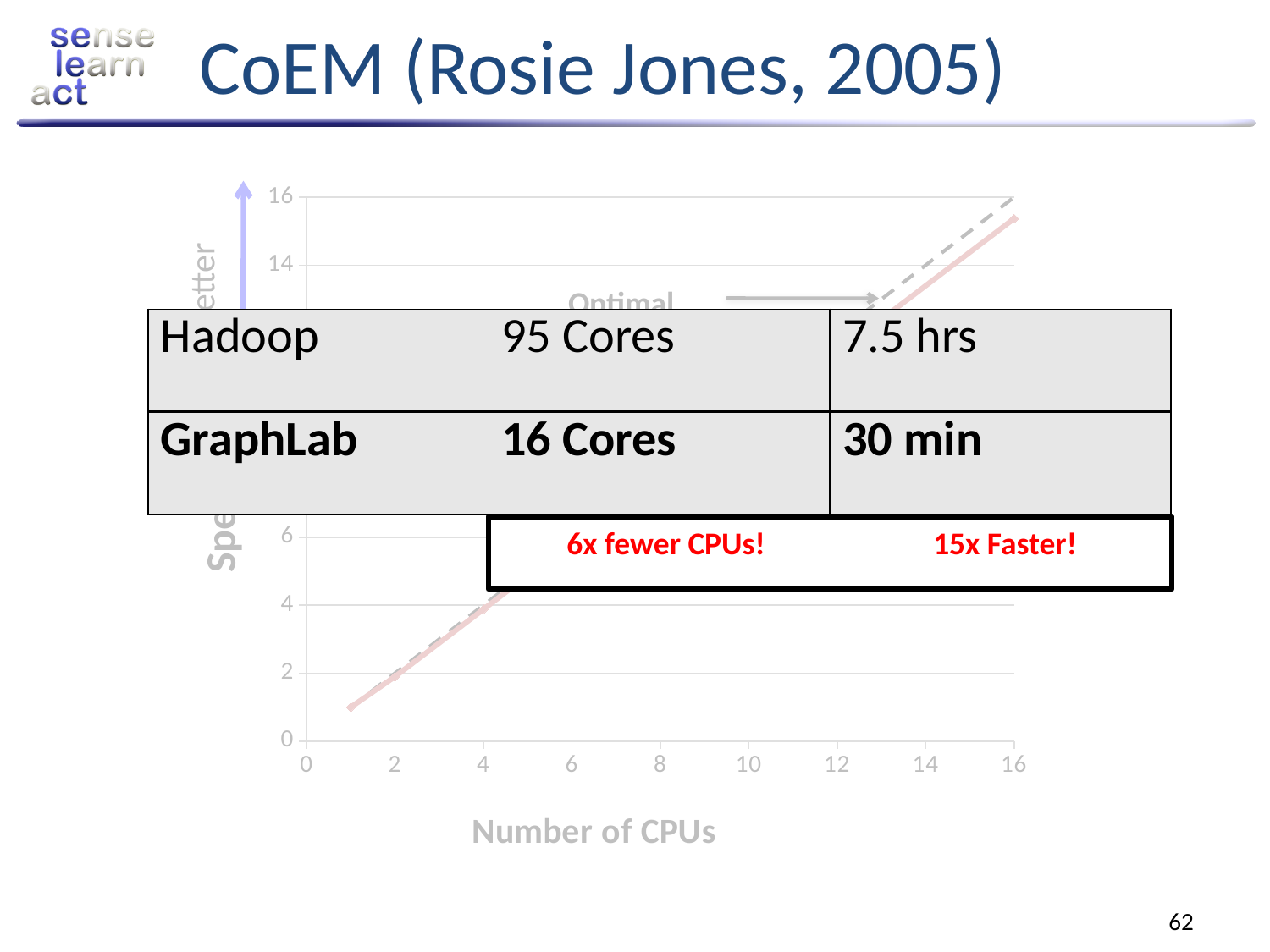
Is the value of the solid line at 16 CPUs greater or less than 14? greater Does the plotted speedup line rise or fall as the number of CPUs increases? rise What kind of chart is shown on the slide? line chart How many lines are plotted in the chart? 2 What is the title of the x axis of the chart? Number of CPUs Is the value of the solid line at 4 CPUs greater or less than 6? less What is the highest value shown on the x axis of the chart? 16 How many tick labels are shown on the x axis of the chart? 9 Is the value of the solid line at 2 CPUs greater or less than 4? less What is the label of the dashed reference line in the chart? Optimal